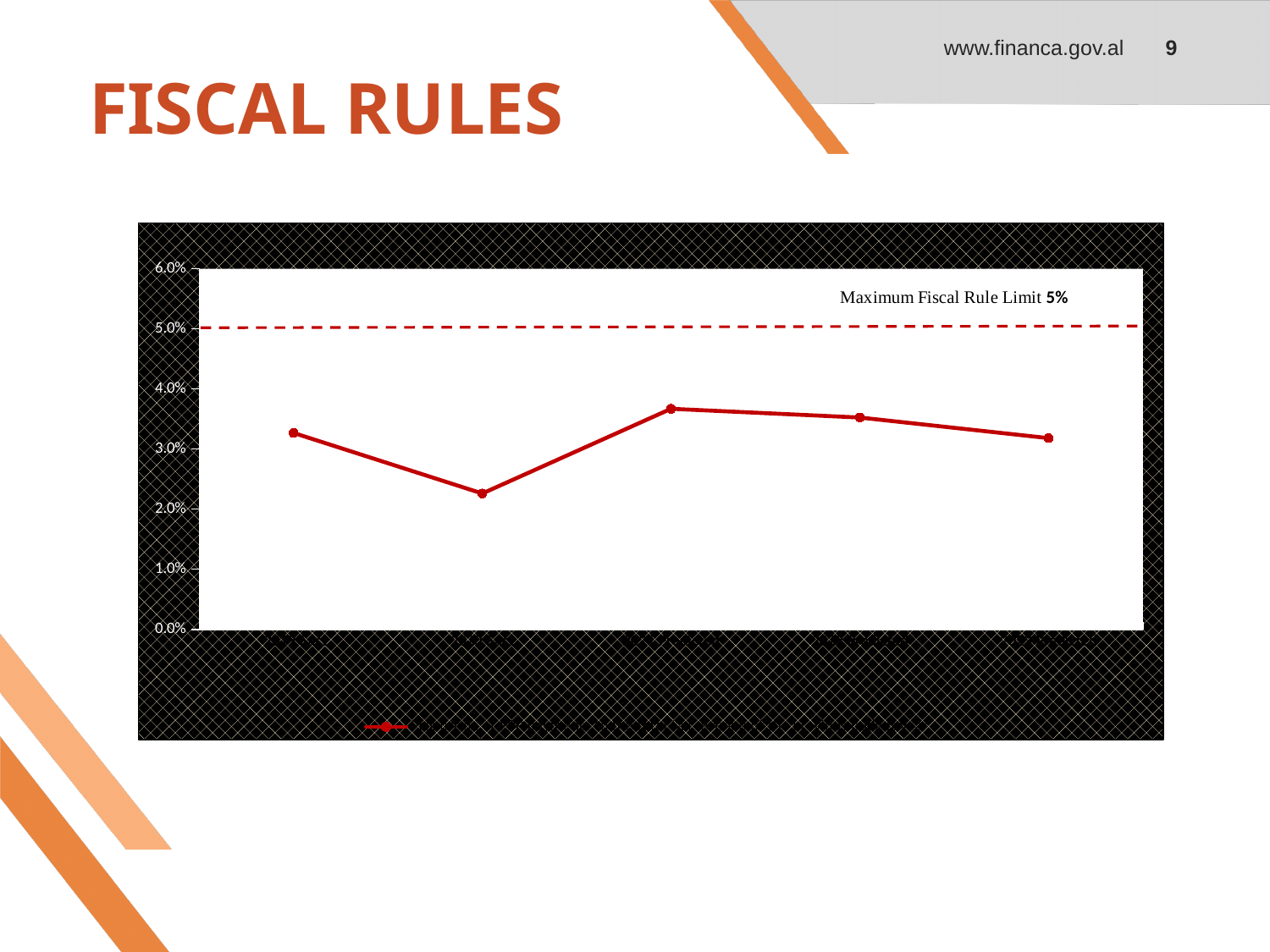
Which point on the line has the lowest value? the second point from the left Is the value of the third point from the left greater or less than 3.0%? greater Is the value of the first point on the left greater or less than 3.0%? greater Does the line rise or fall between the third and fifth points? fall Is the value of the second point from the left greater or less than 3.0%? less What kind of chart is shown on the slide? line chart Does the line rise or fall between the first and second points? fall How many data points are plotted on the line? 5 What does the dashed horizontal line represent? Maximum Fiscal Rule Limit 5% Which point on the line has the highest value? the third point from the left At what value is the Maximum Fiscal Rule Limit drawn? 5%